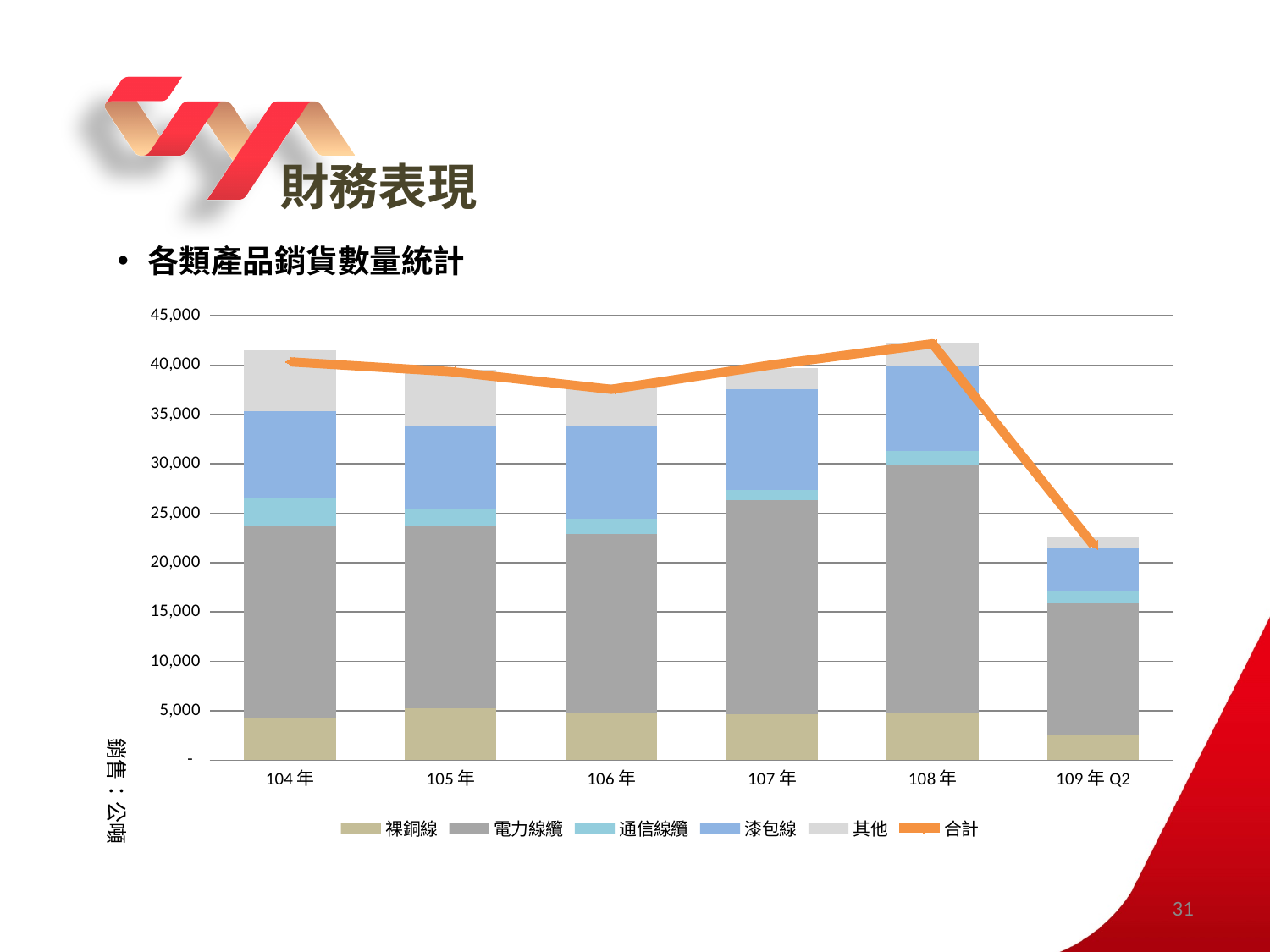
Is the total for 109 年 Q2 greater or less than 25,000? less Which legend entry is drawn as an orange line rather than a bar segment? 合計 How many series does the chart's legend list? 6 Is the total for 106 年 greater or less than 40,000? less Is the total for 108 年 greater or less than 40,000? greater Which category has the lowest total (合計) in the chart? 109 年 Q2 Which category has the highest total (合計) in the chart? 108 年 What is the label on the vertical axis of the chart? 銷售：公噸 Does the 合計 line rise or fall from 108 年 to 109 年 Q2? fall What kind of chart is shown on the slide? A stacked bar chart with a line overlay Which has the larger total, 104 年 or 106 年? 104 年 How many categories are shown on the x axis of the chart? 6